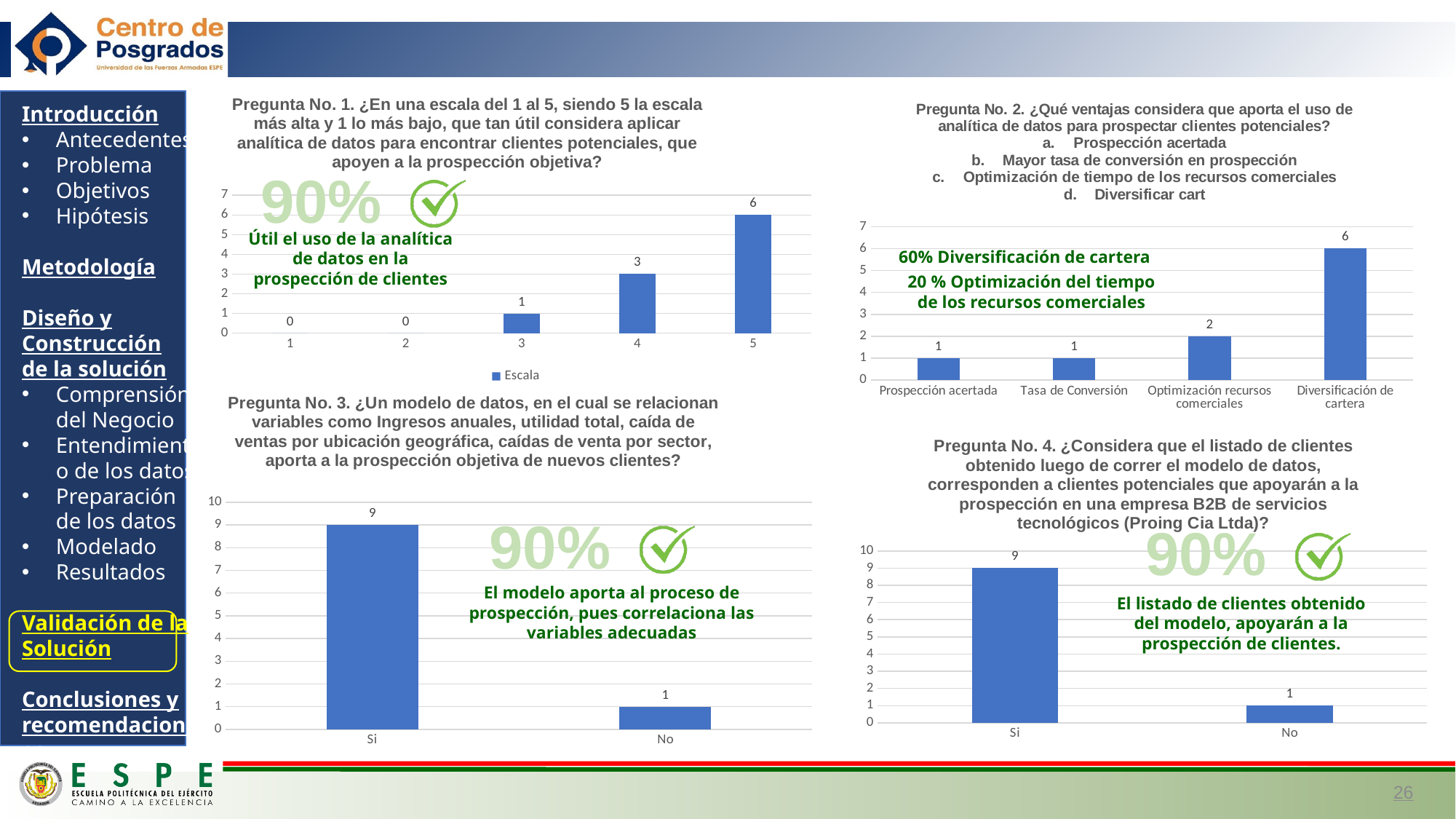
In the Pregunta No. 1 chart, how many categories are shown on the x axis? 5 In the Pregunta No. 2 chart, how many categories are shown? 4 In the Pregunta No. 4 chart, which category is lower, Si or No? No In the Pregunta No. 1 chart, which scale point has the highest value? 5 In the Pregunta No. 3 chart, what is the value for Si? 9 In the Pregunta No. 2 chart, what is the difference between Diversificación de cartera and Optimización recursos comerciales? 4 In the Pregunta No. 2 chart, what is the value for Diversificación de cartera? 6 In the Pregunta No. 1 chart, what is the value for scale point 5? 6 What type of chart is the Pregunta No. 4 chart? Bar chart In the Pregunta No. 1 chart, what is the value for scale point 4? 3 In the Pregunta No. 2 chart, what is the value for Optimización recursos comerciales? 2 In the Pregunta No. 1 chart, what is the name of the series shown in the legend? Escala